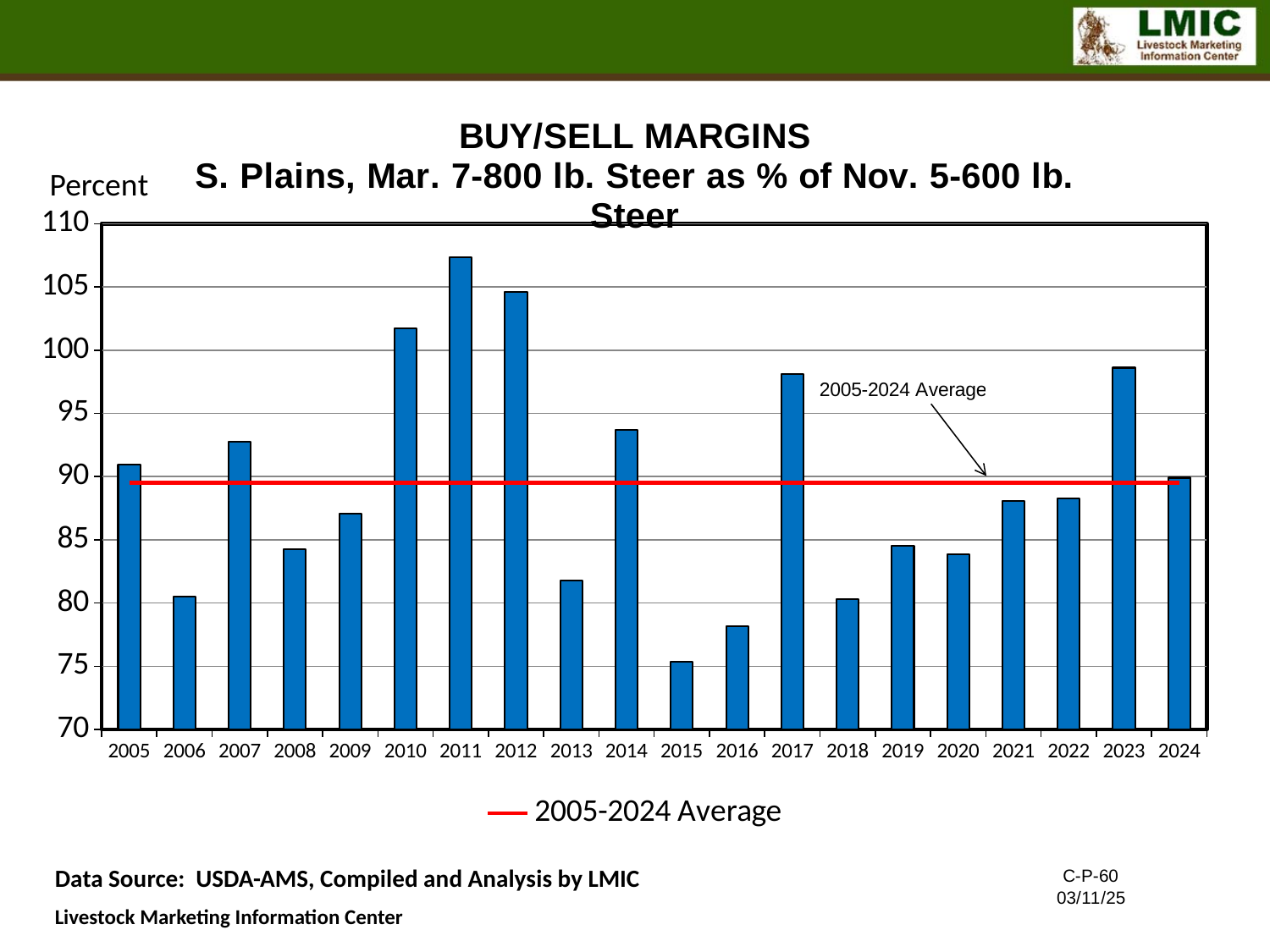
How many years are plotted along the x axis? 20 What label does the legend give to the red horizontal line? 2005-2024 Average What kind of chart is shown on the slide? bar chart Is the value for 2015 greater or less than 80? less Is the value for 2010 greater or less than 100? greater How many entries does the legend list? 1 Which year has the larger value, 2015 or 2016? 2016 Which year has the highest buy/sell margin? 2011 Is the value for 2011 greater or less than 105? greater Which year has the larger value, 2011 or 2012? 2011 Which year has the lowest buy/sell margin? 2015